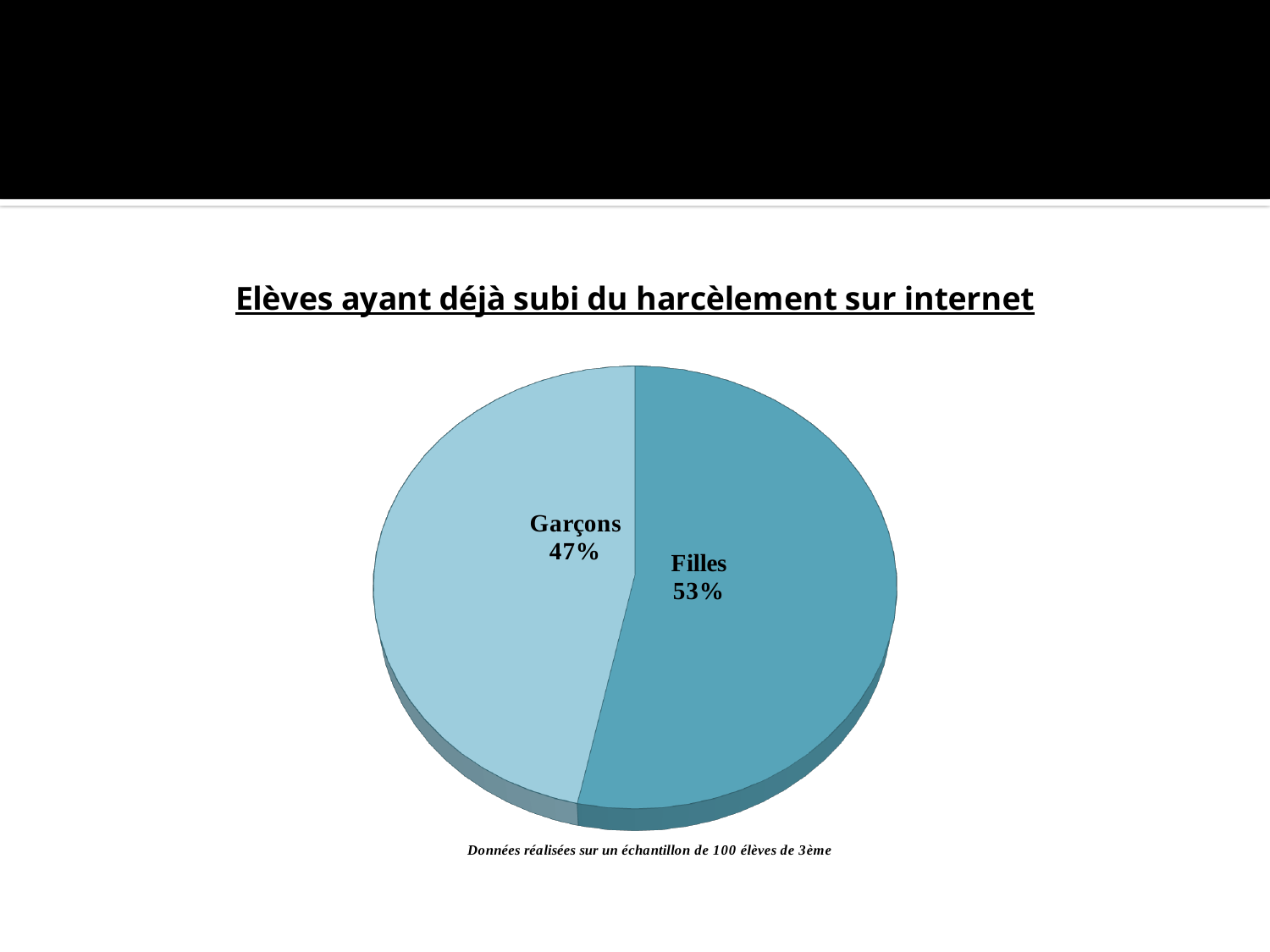
What is the share for Filles? 53% Which is larger, the share for Filles or the share for Garçons? Filles Which slice is the largest? Filles What is the share for Garçons? 47% What is the difference in percentage points between Filles and Garçons? 6 What kind of chart is shown on the slide? pie chart Which slice is the smallest? Garçons What is the title of the chart? Elèves ayant déjà subi du harcèlement sur internet How many slices does the pie chart have? 2 According to the note below the chart, how many students were in the sample? 100